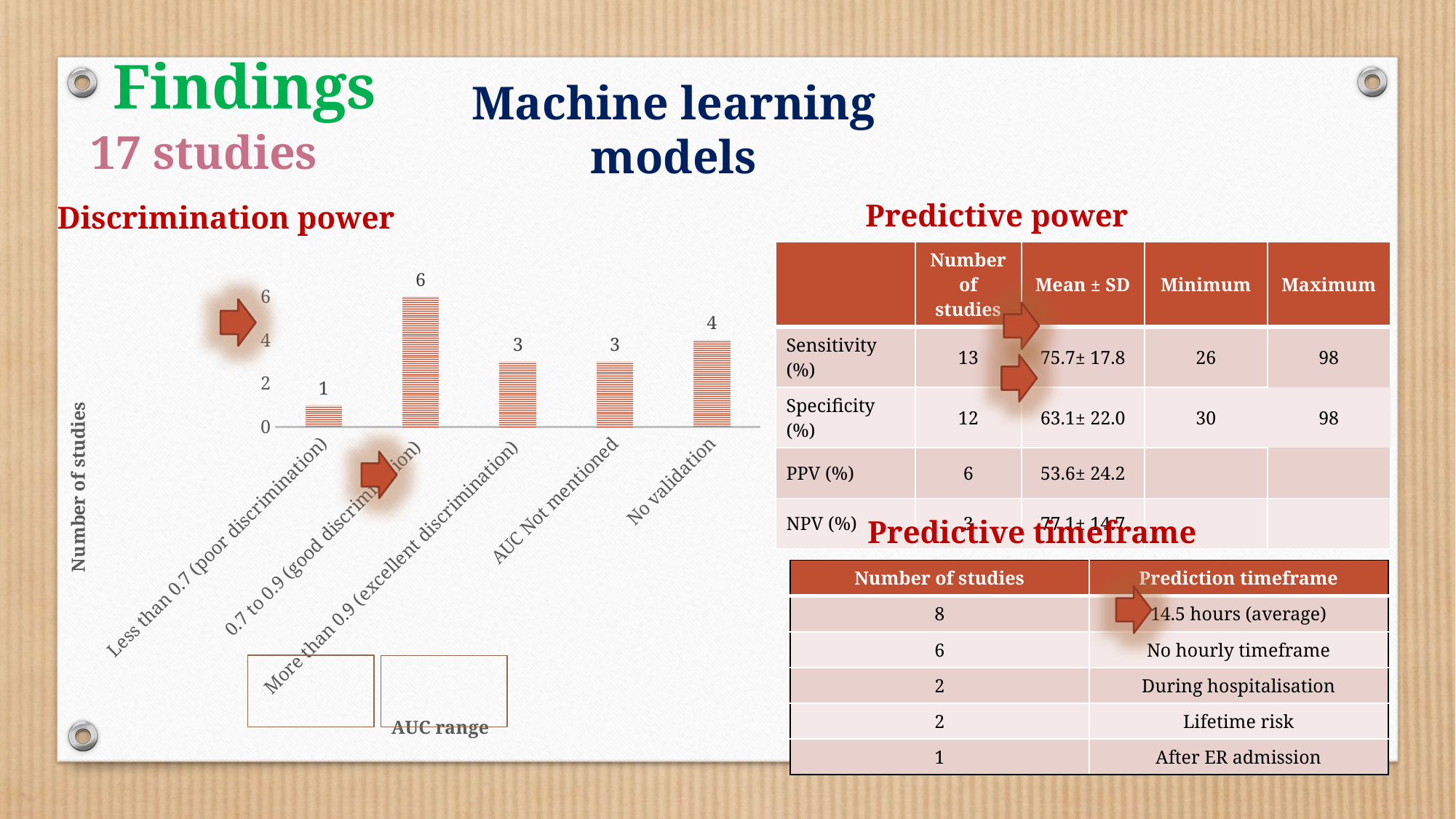
What is the difference in number of studies between "0.7 to 0.9 (good discrimination)" and "No validation"? 2 What type of chart is shown under "Discrimination power"? bar chart How many studies are in the "AUC Not mentioned" category? 3 What is the label of the x axis of the bar chart? AUC range How many studies are in the "Less than 0.7 (poor discrimination)" category? 1 How many studies are in the "No validation" category? 4 How many studies are in the "0.7 to 0.9 (good discrimination)" category? 6 What is the label of the y axis of the bar chart? Number of studies How many categories are shown on the x axis of the bar chart? 5 Which AUC range category has the highest number of studies? 0.7 to 0.9 (good discrimination) Which has more studies: "More than 0.9 (excellent discrimination)" or "No validation"? No validation Which AUC range category has the lowest number of studies? Less than 0.7 (poor discrimination)